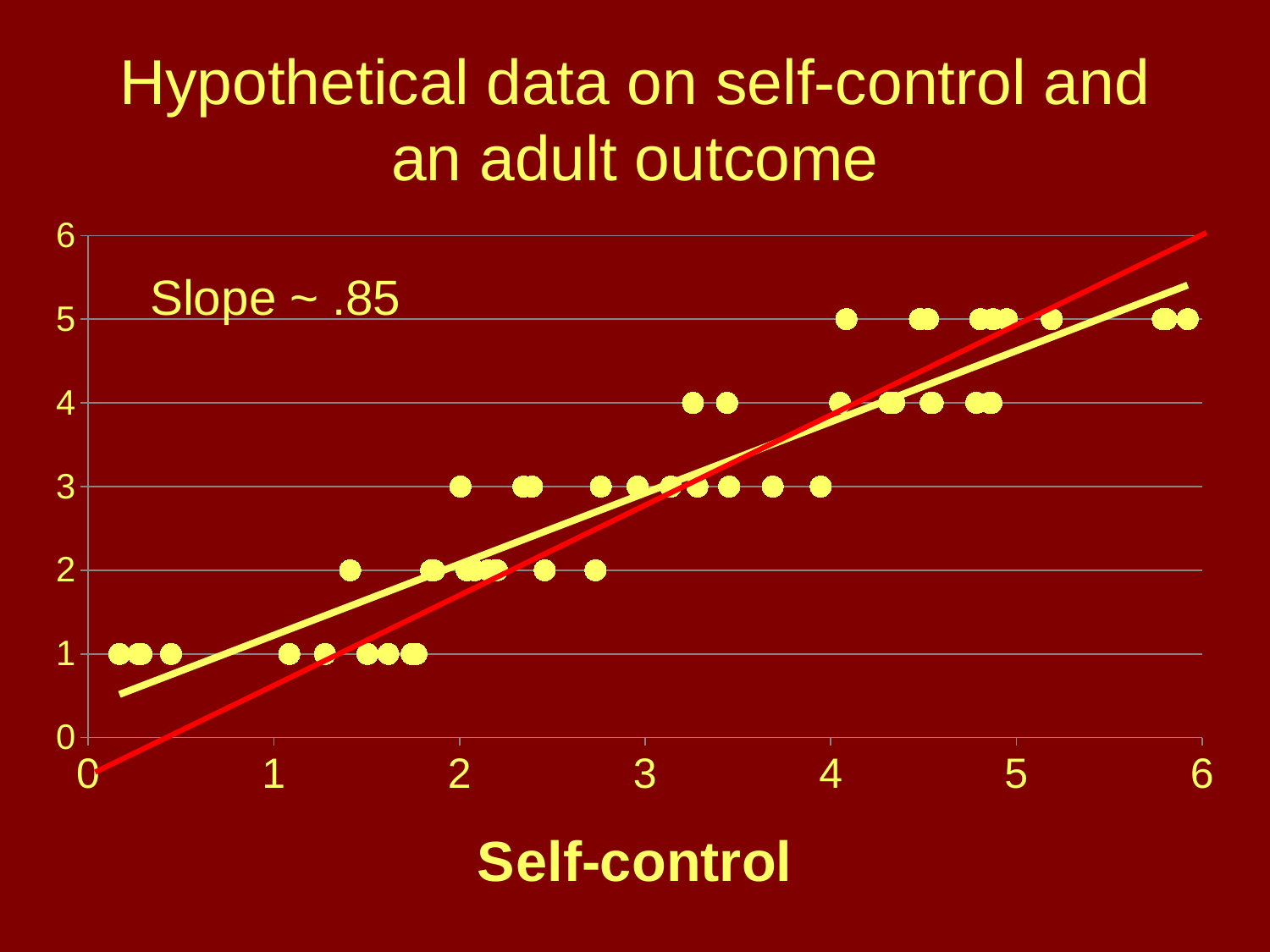
What kind of chart is shown on the slide? scatter chart What slope value is annotated on the chart? Slope ~ .85 What is the highest outcome value reached by any plotted point? 5 What is the highest x-axis tick value shown on the chart? 6 What is the highest y-axis tick value shown on the chart? 6 What is the label of the x axis? Self-control Do the plotted values generally rise or fall as self-control increases along the x axis? rise Which has the higher outcome value: the points near self-control 1 or the points near self-control 5? the points near self-control 5 Is the outcome value for the points near self-control 6 greater or less than 4? greater What is the title of the chart? Hypothetical data on self-control and an adult outcome What is the lowest outcome value reached by any plotted point? 1 Is the outcome value for the points near self-control 0 greater or less than 2? less